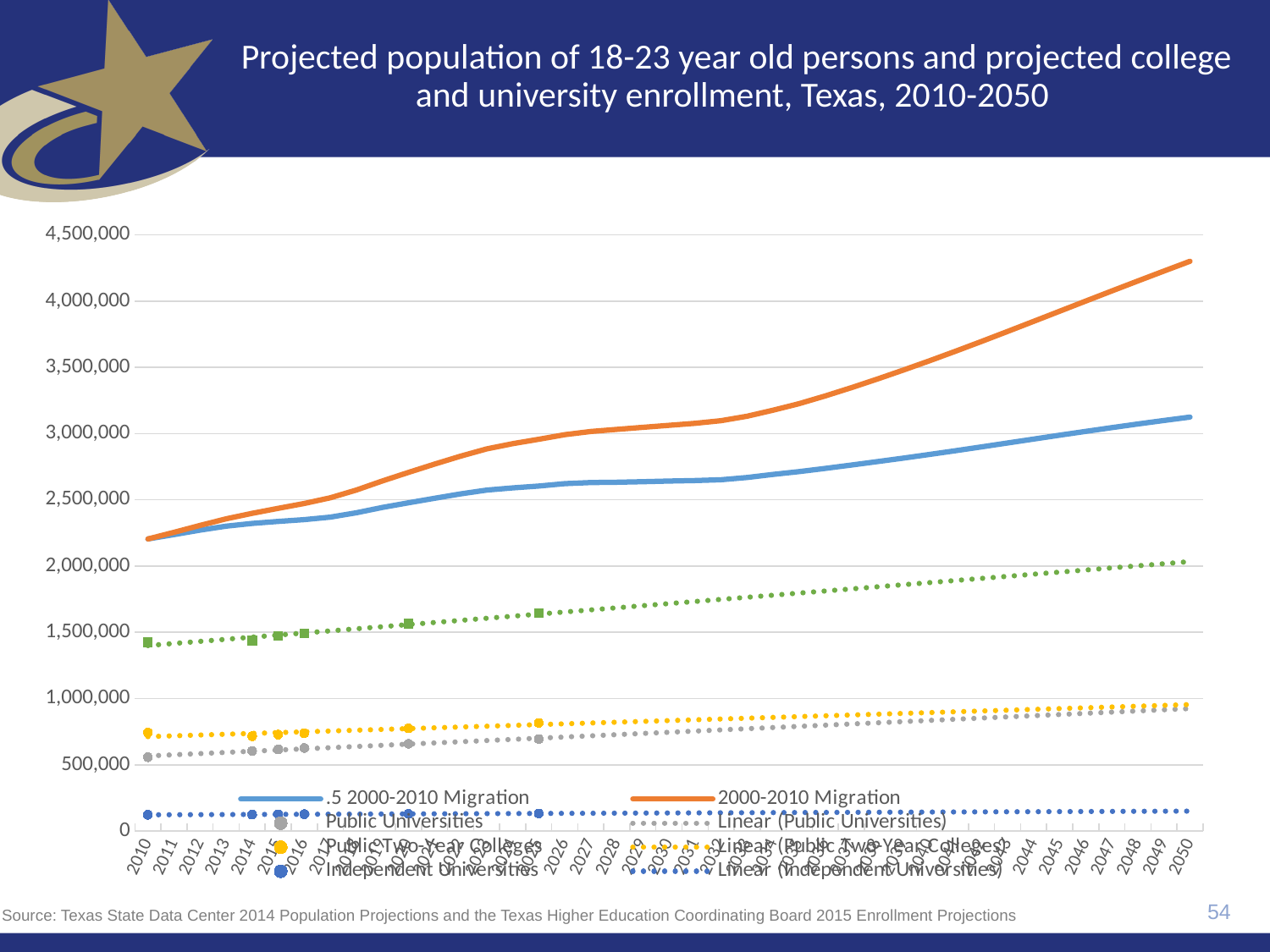
What is the title of the chart? Projected population of 18-23 year old persons and projected college and university enrollment, Texas, 2010-2050 How many entries does the chart legend list? 8 Which series has the highest value in 2050? 2000-2010 Migration How many years are shown along the x axis? 41 Is the value for Public Two-Year Colleges in 2010 greater or less than 500,000? greater Is the value for the .5 2000-2010 Migration series in 2050 greater or less than 3,500,000? less What kind of chart is shown on the slide? line chart Is the value for the 2000-2010 Migration series in 2050 greater or less than 4,000,000? greater Does the 2000-2010 Migration series rise or fall from 2010 to 2050? rise Which series has the lowest values across the chart? Independent Universities